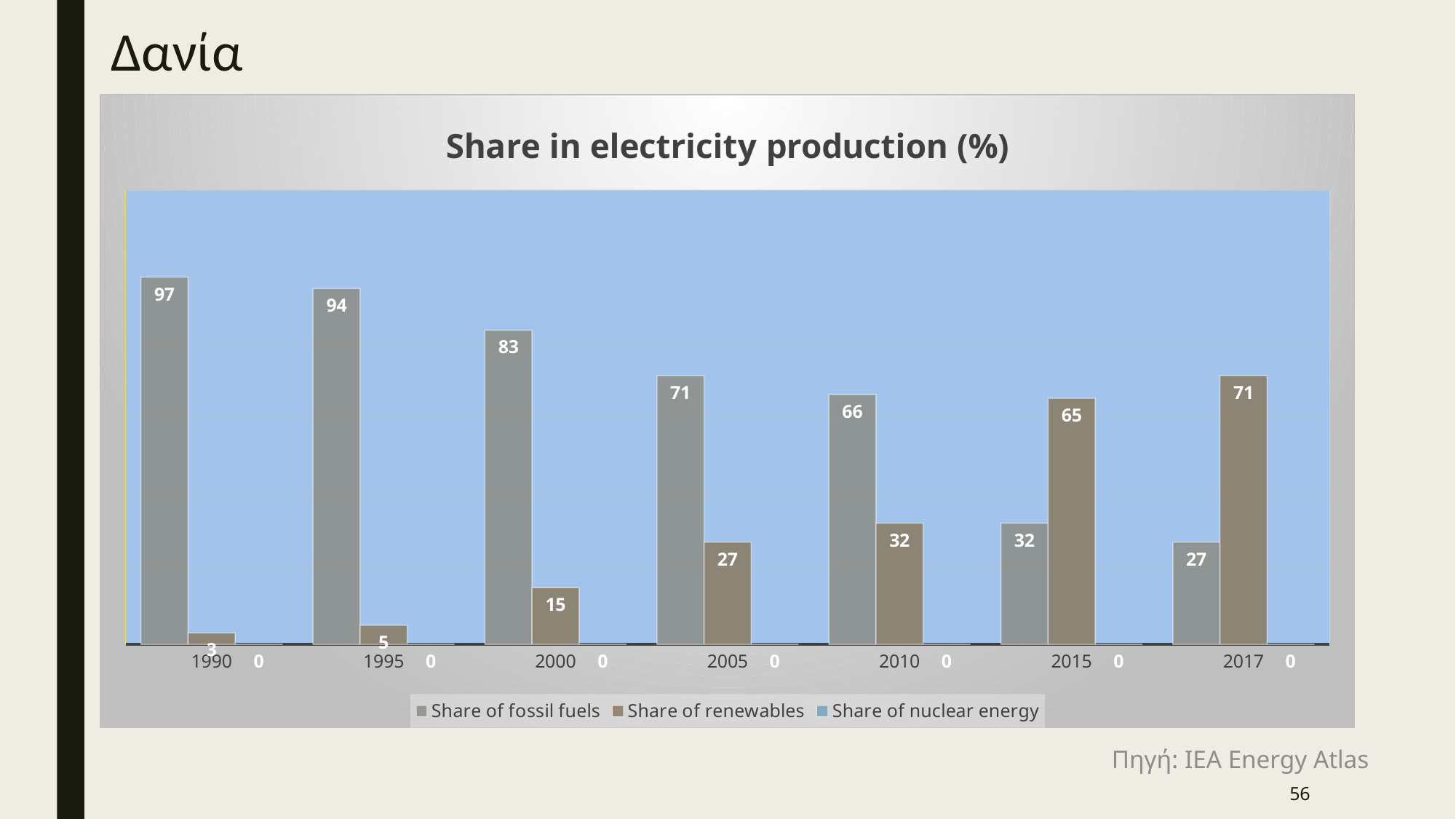
In which year is the share of renewables highest? 2017 In 2015, which is larger: the share of fossil fuels or the share of renewables? Share of renewables What is the difference between the share of fossil fuels and the share of renewables in 2010? 34 What is the share of renewables in 2017? 71 What is the share of fossil fuels in 1990? 97 Does the share of fossil fuels rise or fall from 1990 to 2017? Fall How many series does the legend list? 3 In which year is the share of fossil fuels lowest? 2017 What is the title of the chart? Share in electricity production (%) How many years are shown on the x axis? 7 What kind of chart is shown on the slide? Bar chart What is the share of nuclear energy in 2005? 0